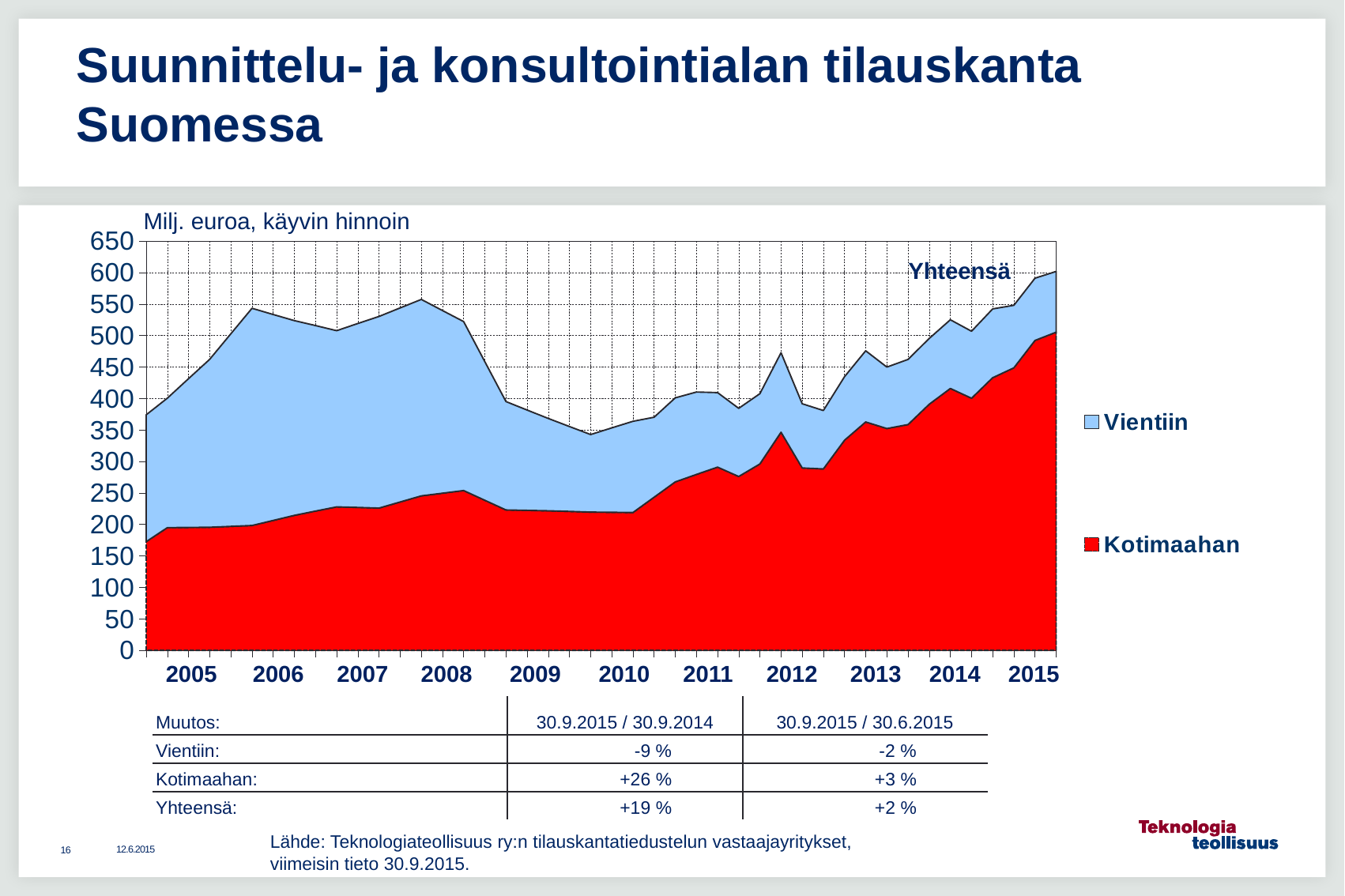
How many series does the chart legend list? 2 According to the table below the chart, what is the change in Kotimaahan for 30.9.2015 / 30.9.2014? +26 % How many years are labelled on the chart's x axis? 11 Is the Kotimaahan value at the end of 2015 greater or less than 450? greater What kind of chart is shown on the slide? Stacked area chart Is the Yhteensä (total) value in 2009 greater or less than 400? less Does the Yhteensä (total) line rise or fall from 2008 to 2009? fall Does the Kotimaahan series rise or fall from 2012 to 2015? rise What unit is stated above the chart's y axis? Milj. euroa, käyvin hinnoin What are the two series named in the chart legend? Vientiin and Kotimaahan Is the Yhteensä (total) value at the end of 2015 greater or less than 550? greater